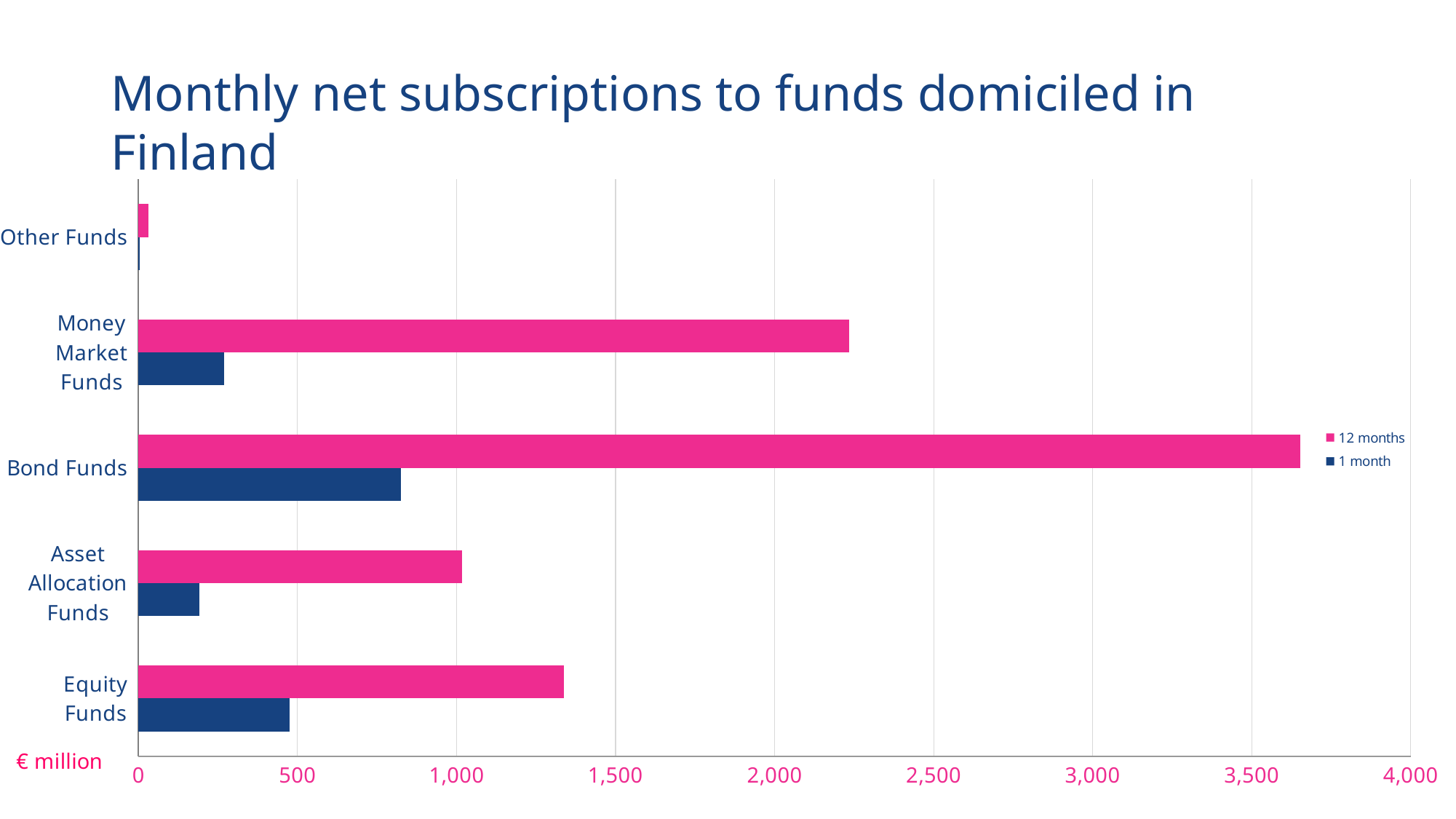
Is the 1 month value for Asset Allocation Funds greater or less than 500? less Which fund category has the lowest 12 months value? Other Funds Which is larger: the 12 months value for Equity Funds or the 12 months value for Asset Allocation Funds? Equity Funds What type of chart is shown on the slide? Bar chart Is the 12 months value for Money Market Funds greater or less than 2,000? greater How many series does the legend list? 2 What unit is shown for the values on the chart? € million Which fund category has the highest 12 months value? Bond Funds Is the 12 months value for Bond Funds greater or less than 3,500? greater Which fund category has the highest 1 month value? Bond Funds How many fund categories are shown on the chart? 5